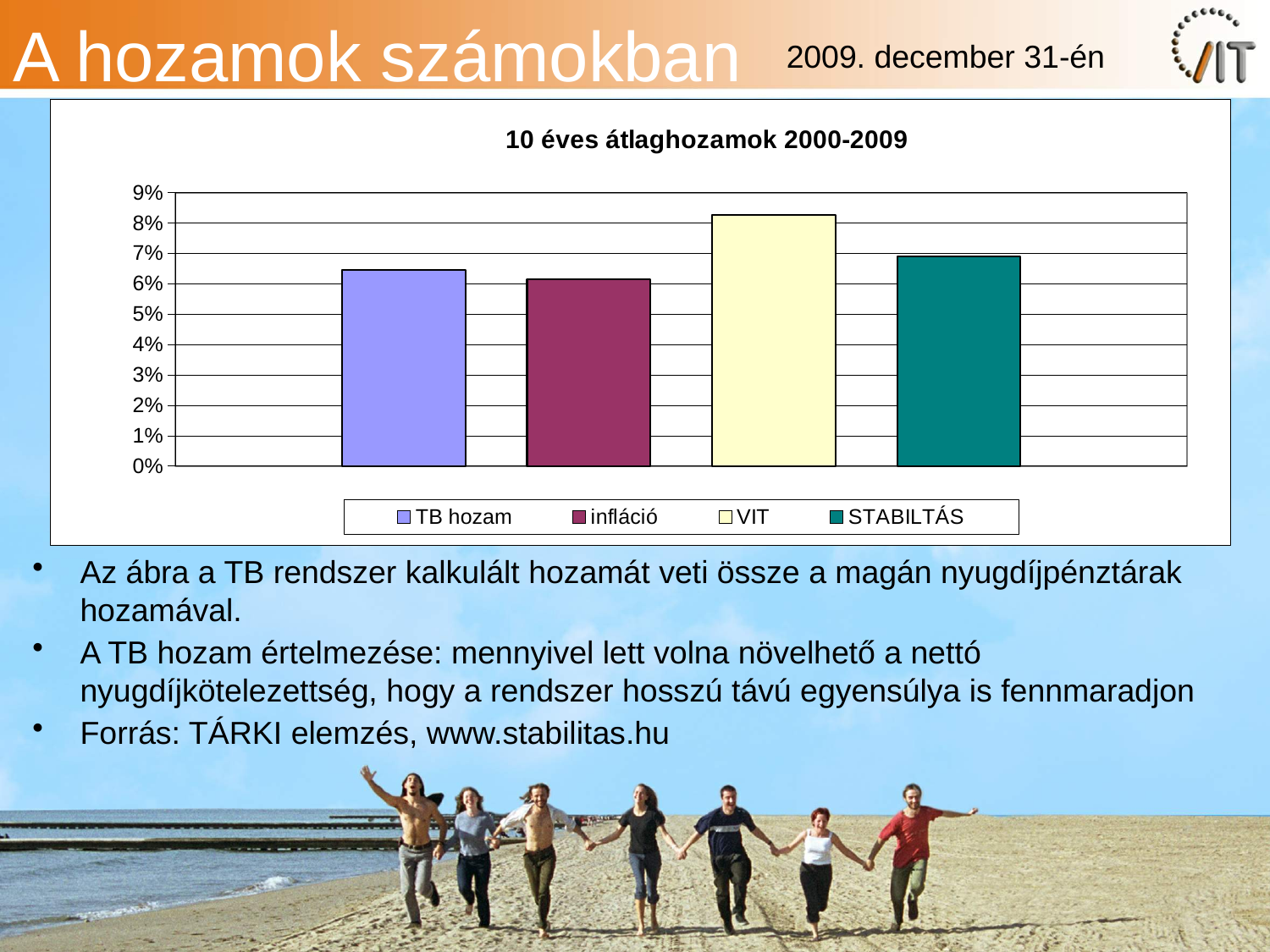
Which series has the highest 10-year average return in the chart? VIT Which colour is used for the STABILTÁS bar in the chart? teal (dark green) How many bars are plotted in the chart? 4 Which is larger in the chart, the value for VIT or the value for STABILTÁS? VIT Which is larger in the chart, the value for TB hozam or the value for infláció? TB hozam How many entries does the chart legend list? 4 What is the title of the chart? 10 éves átlaghozamok 2000-2009 Is the value for infláció greater or less than 7%? less Which series has the lowest value in the chart? infláció Is the value for TB hozam greater or less than 6%? greater What kind of chart is shown on the slide? bar chart Is the value for VIT greater or less than 7%? greater